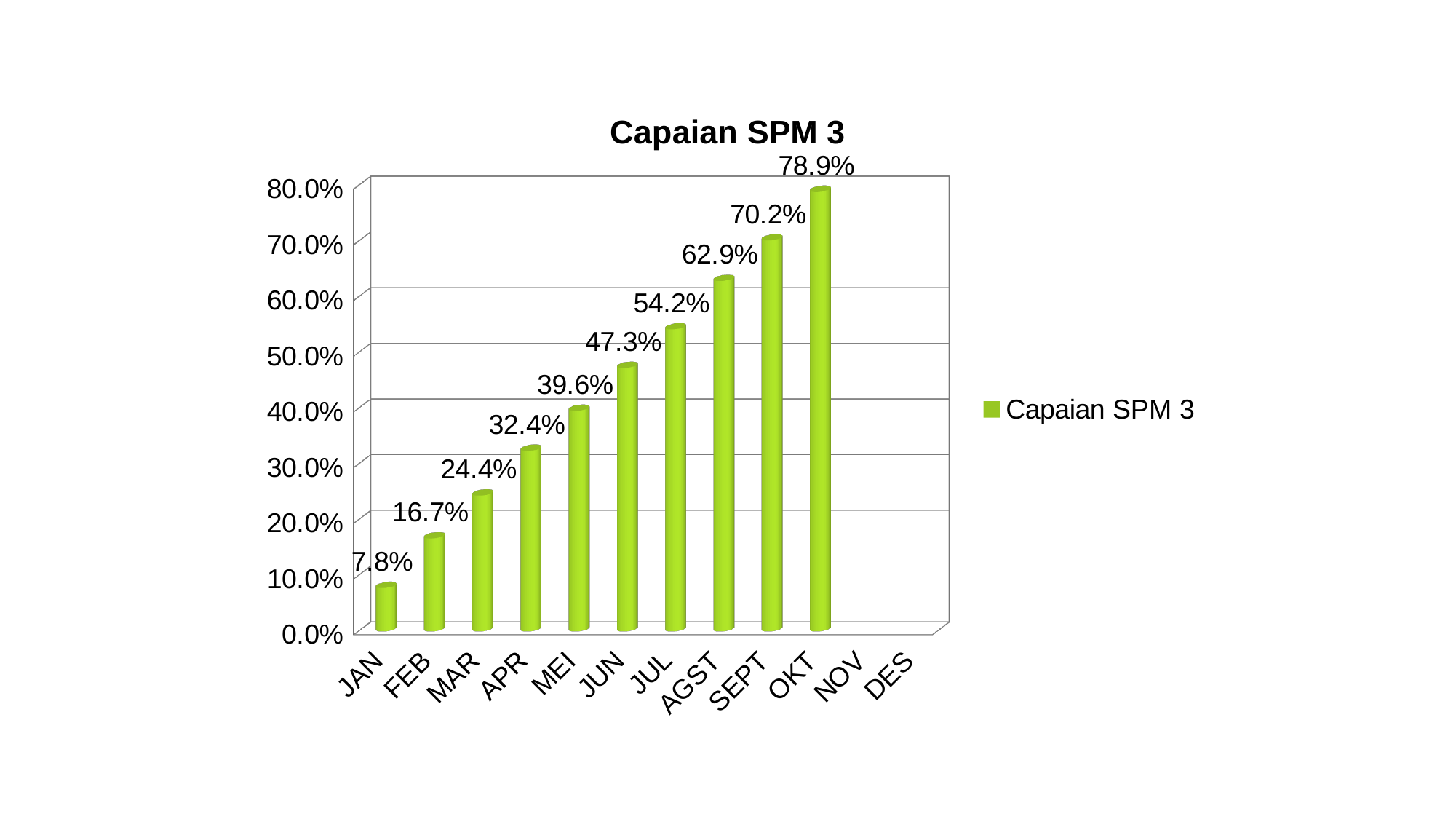
What is the value for JUL? 54.2% Which month with a plotted bar has the lowest value? JAN What is the difference between the values for SEPT and AGST? 7.3% Is the value for JUN greater or less than 50.0%? less How many series does the legend list? 1 Which month has the highest value? OKT Which is larger, the value for MEI or the value for APR? MEI Do the values rise or fall from JAN to OKT? rise How many months have a plotted bar? 10 What is the value for OKT? 78.9% What is the value for MAR? 24.4% What kind of chart is shown? bar chart